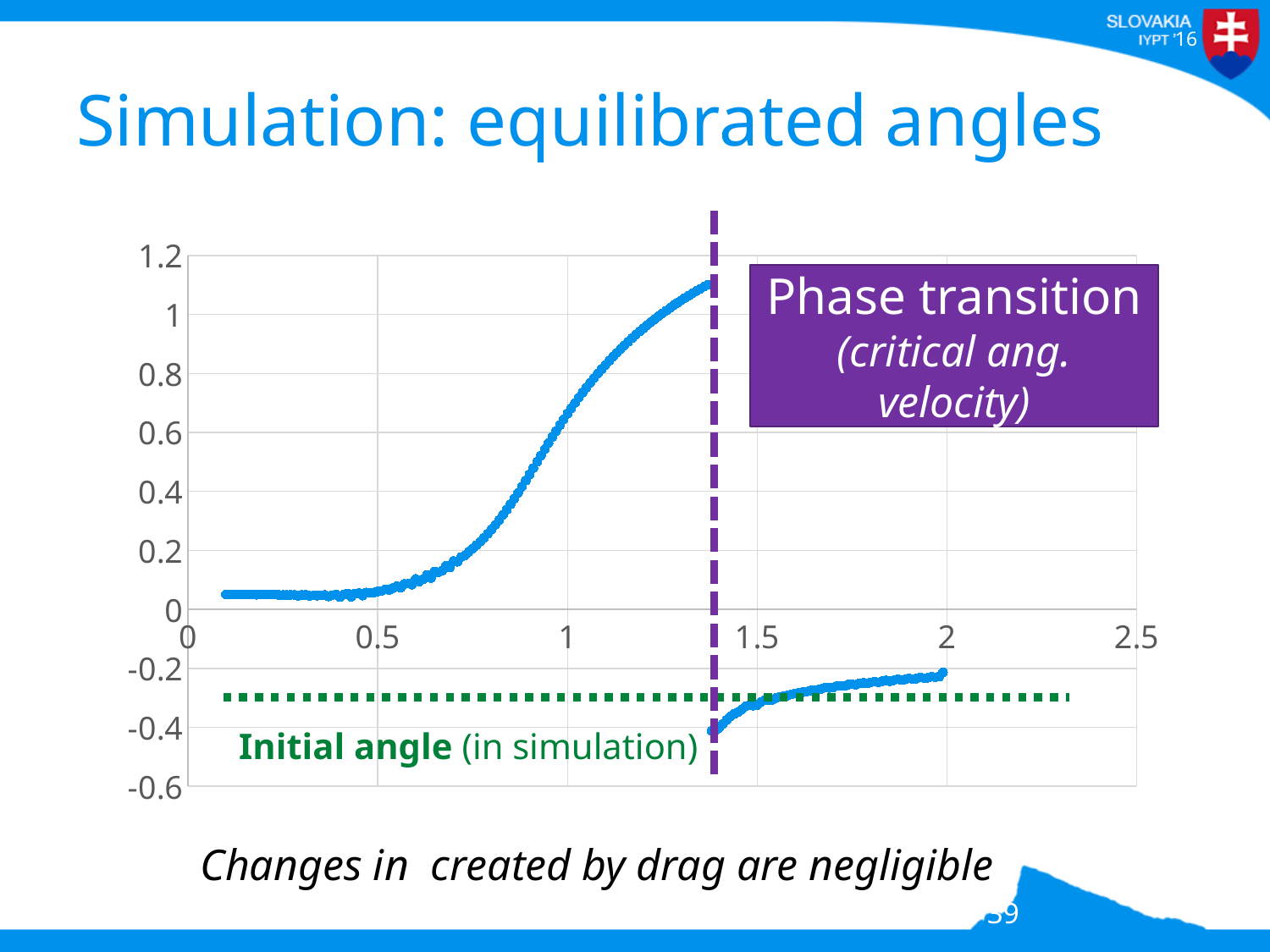
Is the plotted value at x = 1.2 greater or less than 0.8? greater Is the highest plotted value, reached just before the dashed vertical line, greater or less than 1? greater Is the lowest plotted value, just after the dashed vertical line, greater or less than -0.2? less Do the plotted values rise or fall as x increases from about 1.4 to 2? rise What kind of chart is shown on the slide? scatter chart Is the plotted value at x = 1.5 larger or smaller than the plotted value at x = 1? smaller What does the dashed vertical purple line on the chart mark? Phase transition (critical ang. velocity) Do the plotted values rise or fall as x increases from 0.5 to about 1.4? rise What does the dotted green horizontal line on the chart represent? Initial angle (in simulation)